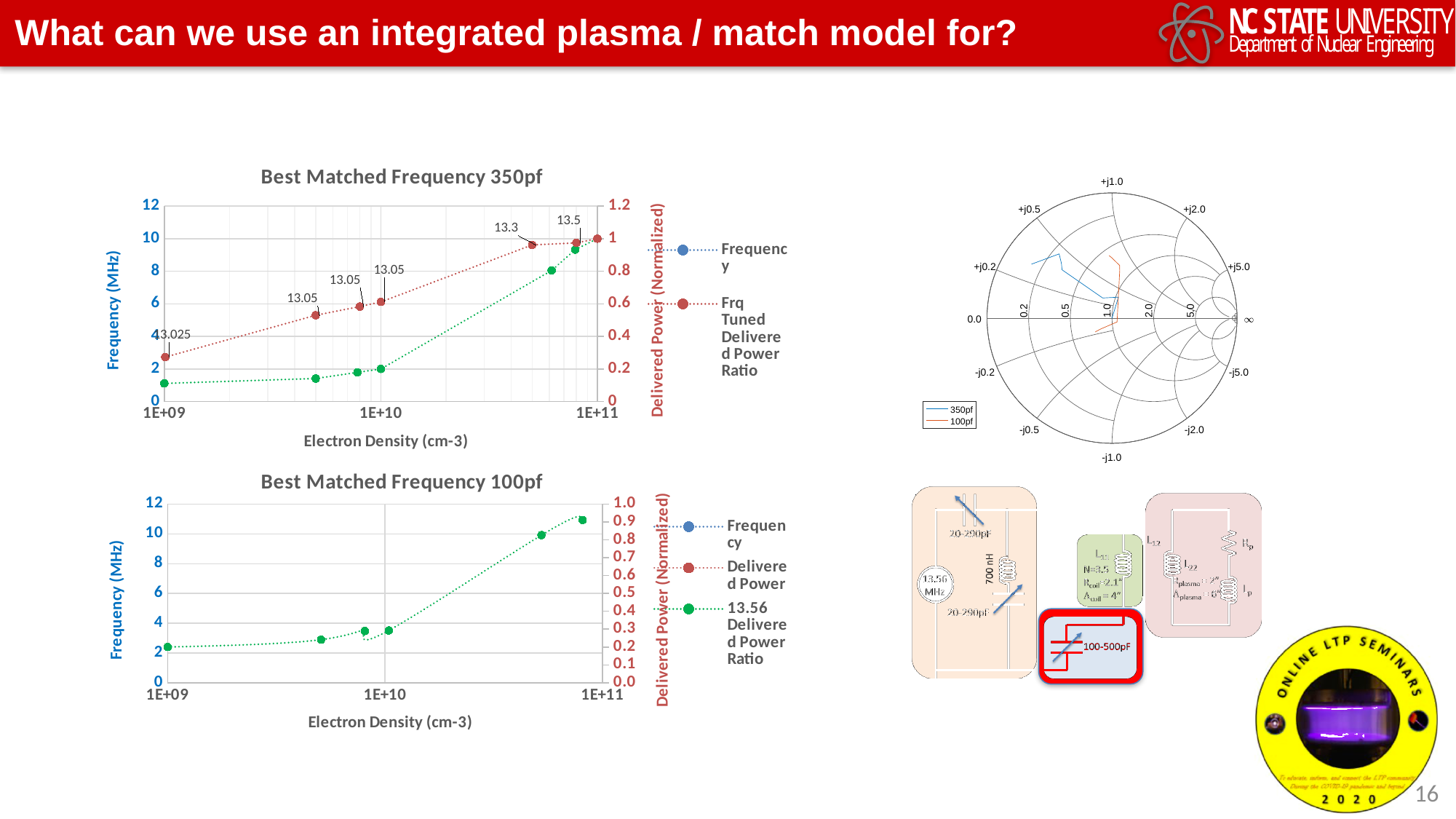
In the Smith chart on the right of the slide, what two entries does the legend list? 350pf and 100pf In the 'Best Matched Frequency 350pf' chart, which printed data label is the largest? 13.5 In the 'Best Matched Frequency 350pf' chart, how many series does the legend list? 2 What is the x-axis title of the 'Best Matched Frequency 100pf' chart? Electron Density (cm-3) In the 'Best Matched Frequency 350pf' chart, how many data labels are printed on the plot? 6 In the 'Best Matched Frequency 100pf' chart, how many series does the legend list? 3 What kind of chart is 'Best Matched Frequency 350pf'? line chart In the 'Best Matched Frequency 350pf' chart, is the red series value at 1E+09 on the right axis greater or less than 0.4? less In the 'Best Matched Frequency 350pf' chart, what data label is shown at the highest electron density point? 13.5 In the 'Best Matched Frequency 100pf' chart, does the green series rise or fall as electron density increases? rise In the 'Best Matched Frequency 100pf' chart, is the green series value at 1E+11 on the right axis greater or less than 0.8? greater In the 'Best Matched Frequency 350pf' chart, what data label is shown at the lowest electron density point? 13.025